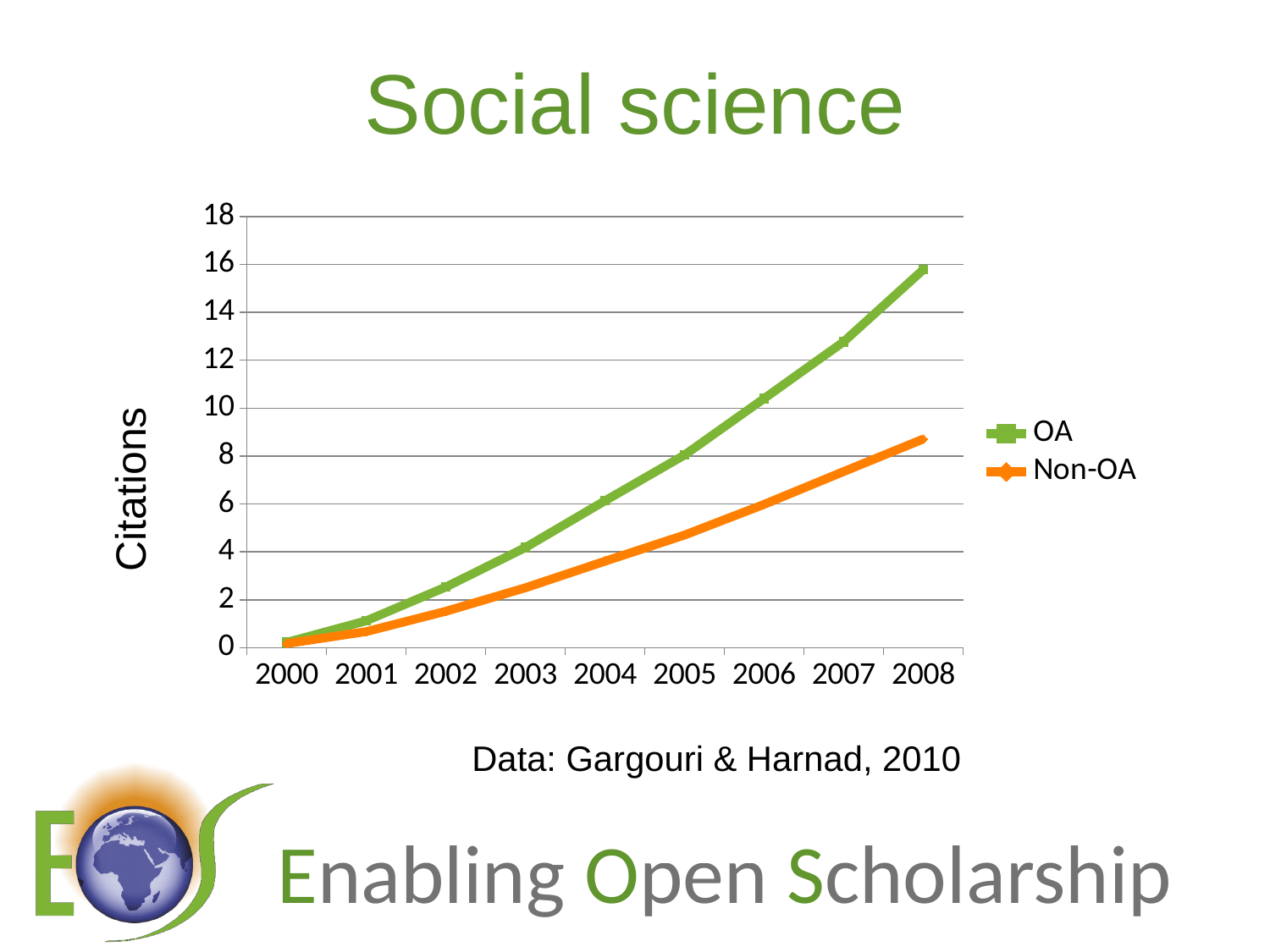
Is the value for OA in 2008 greater or less than 14? greater Is the value for Non-OA in 2005 greater or less than 6? less Is the value for OA in 2007 greater or less than 12? greater What type of chart is shown on the slide? line chart In which year does the OA series reach its highest value? 2008 How many series does the legend list? 2 How many years are shown on the x axis? 9 What is the label on the y axis? Citations Which series has the higher value in 2008, OA or Non-OA? OA Do the OA citations rise or fall from 2000 to 2008? rise In which year is the Non-OA series at its lowest value? 2000